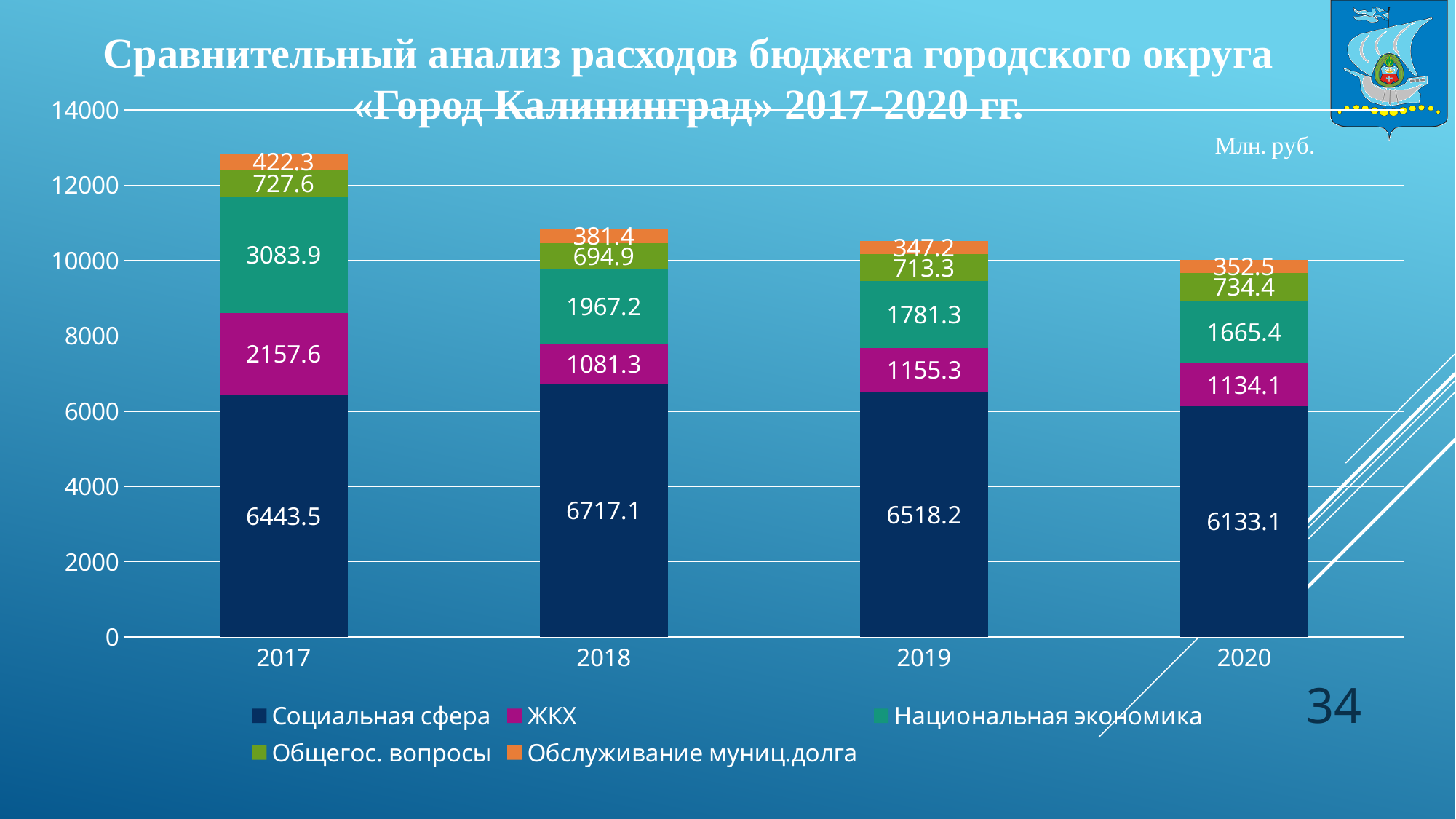
How many years are shown on the x axis? 4 What is the value for Обслуживание муниц.долга in 2020? 352.5 In which year is the value for Социальная сфера the highest? 2018 Which is larger: Общегос. вопросы in 2020 or in 2019? 2020 How many series does the legend list? 5 What is the value for Национальная экономика in 2019? 1781.3 Is the total of the stacked bar for 2017 greater or less than 12000? greater What kind of chart is shown on the slide? stacked bar chart What is the value for Социальная сфера in 2017? 6443.5 What is the difference between the Социальная сфера values for 2018 and 2017? 273.6 In which year is the value for ЖКХ the lowest? 2018 What is the total of the stacked bar for 2020? 10019.5